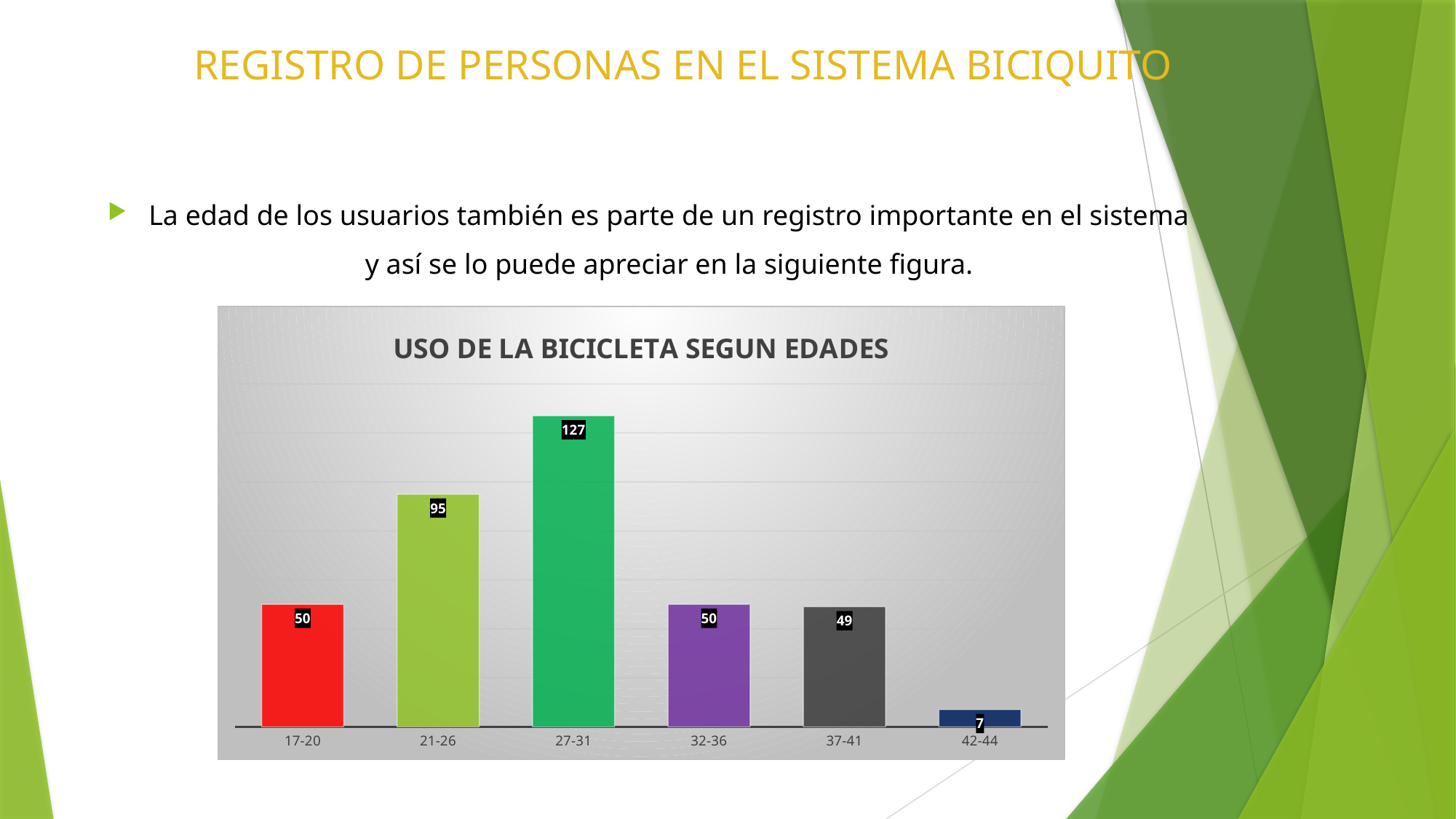
What is the value for the 21-26 age group? 95 What is the value for the 42-44 age group? 7 Which age group has the lowest value? 42-44 What kind of chart is shown on the slide? Bar chart How many age groups are shown on the x axis? 6 What is the value for the 27-31 age group? 127 Which age group has the highest value? 27-31 What is the title of the chart? USO DE LA BICICLETA SEGUN EDADES Which is larger, the value for 21-26 or the value for 32-36? 21-26 What is the value for the 37-41 age group? 49 What is the difference between the values for 27-31 and 21-26? 32 What is the difference between the values for 17-20 and 42-44? 43